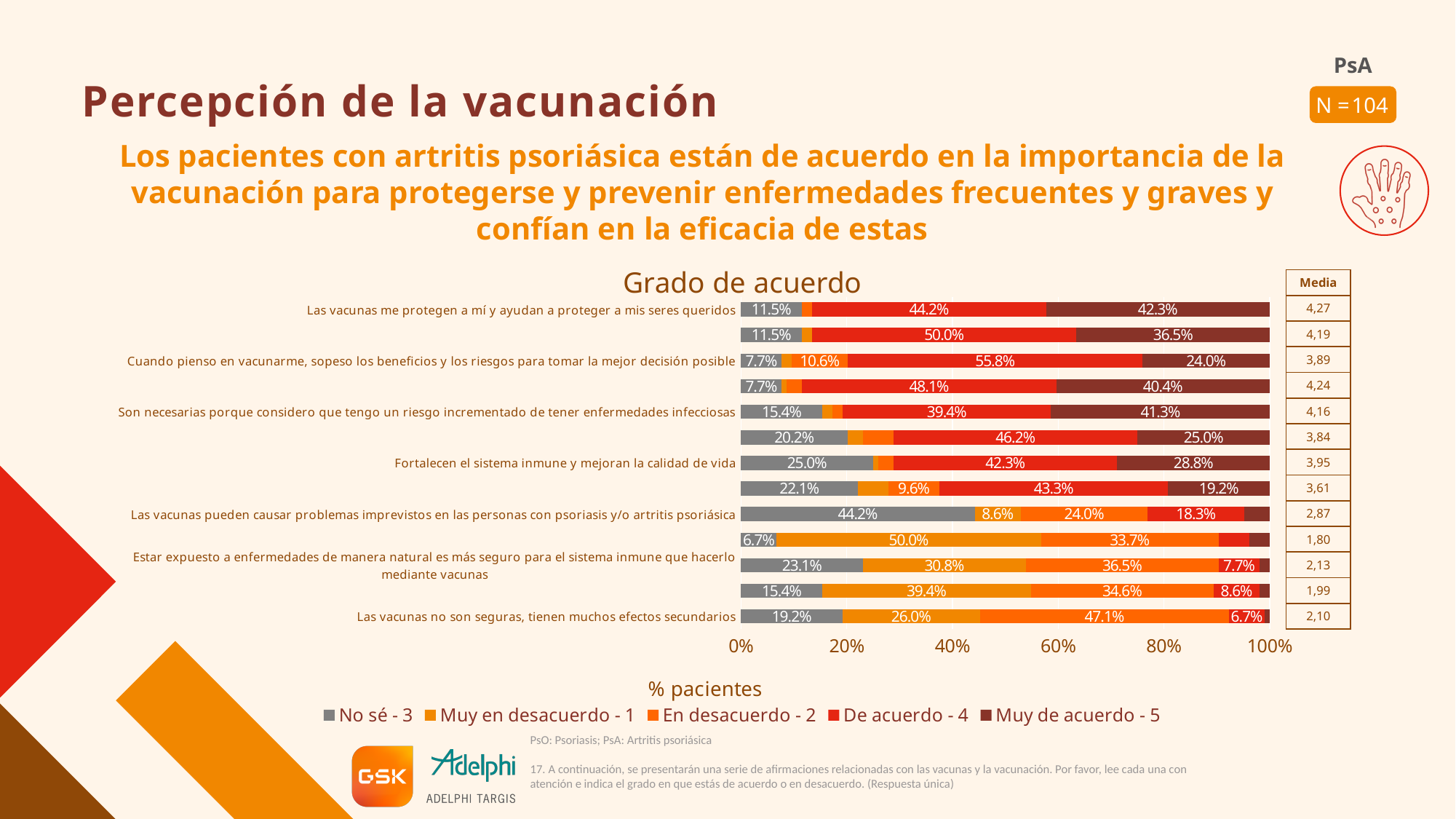
What percentage of patients answered 'En desacuerdo - 2' for 'Las vacunas no son seguras, tienen muchos efectos secundarios'? 47.1% What percentage of patients answered 'Muy de acuerdo - 5' for 'Las vacunas me protegen a mí y ayudan a proteger a mis seres queridos'? 42.3% What kind of chart is shown on the slide? stacked bar chart How many bars are plotted in the chart? 13 Which labelled statement has the highest 'No sé - 3' percentage? Las vacunas pueden causar problemas imprevistos en las personas con psoriasis y/o artritis psoriásica Which is larger: the 'Muy de acuerdo - 5' share for 'Son necesarias porque considero que tengo un riesgo incrementado de tener enfermedades infecciosas' or for 'Fortalecen el sistema inmune y mejoran la calidad de vida'? Son necesarias porque considero que tengo un riesgo incrementado de tener enfermedades infecciosas What is the title of the chart? Grado de acuerdo What percentage of patients answered 'No sé - 3' for 'Las vacunas pueden causar problemas imprevistos en las personas con psoriasis y/o artritis psoriásica'? 44.2% What is the difference between the 'De acuerdo - 4' share (44.2%) and the 'Muy de acuerdo - 5' share (42.3%) for 'Las vacunas me protegen a mí y ayudan a proteger a mis seres queridos'? 1.9% How many series does the legend list? 5 What percentage of patients answered 'De acuerdo - 4' for 'Cuando pienso en vacunarme, sopeso los beneficios y los riesgos para tomar la mejor decisión posible'? 55.8% What is the 'Media' value for 'Fortalecen el sistema inmune y mejoran la calidad de vida'? 3,95